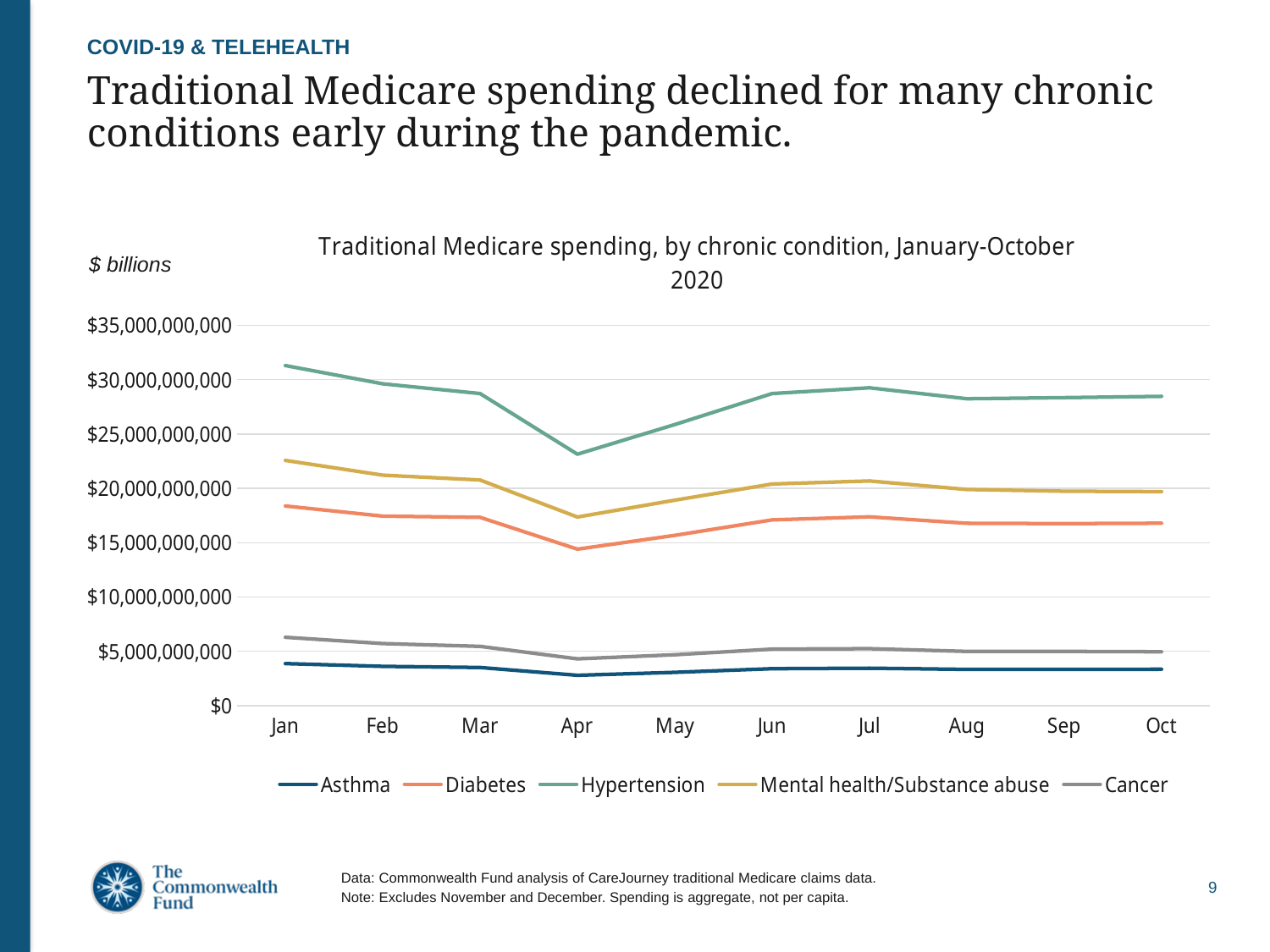
In which month is Hypertension spending at its highest? Jan In which month is Hypertension spending at its lowest? Apr Does Hypertension spending rise or fall from Jan to Apr? fall What kind of chart is shown on the slide? line chart Is the value for Hypertension in Jan greater or less than $30,000,000,000? greater How many series does the legend list? 5 Is the value for Mental health/Substance abuse in Jan greater or less than $20,000,000,000? greater Which chronic condition has the lowest traditional Medicare spending across the months shown? Asthma Is the value for Diabetes in Apr greater or less than $15,000,000,000? less How many months are plotted along the x axis? 10 Which is larger in Jul: spending for Diabetes or for Mental health/Substance abuse? Mental health/Substance abuse Which chronic condition has the highest traditional Medicare spending across the months shown? Hypertension